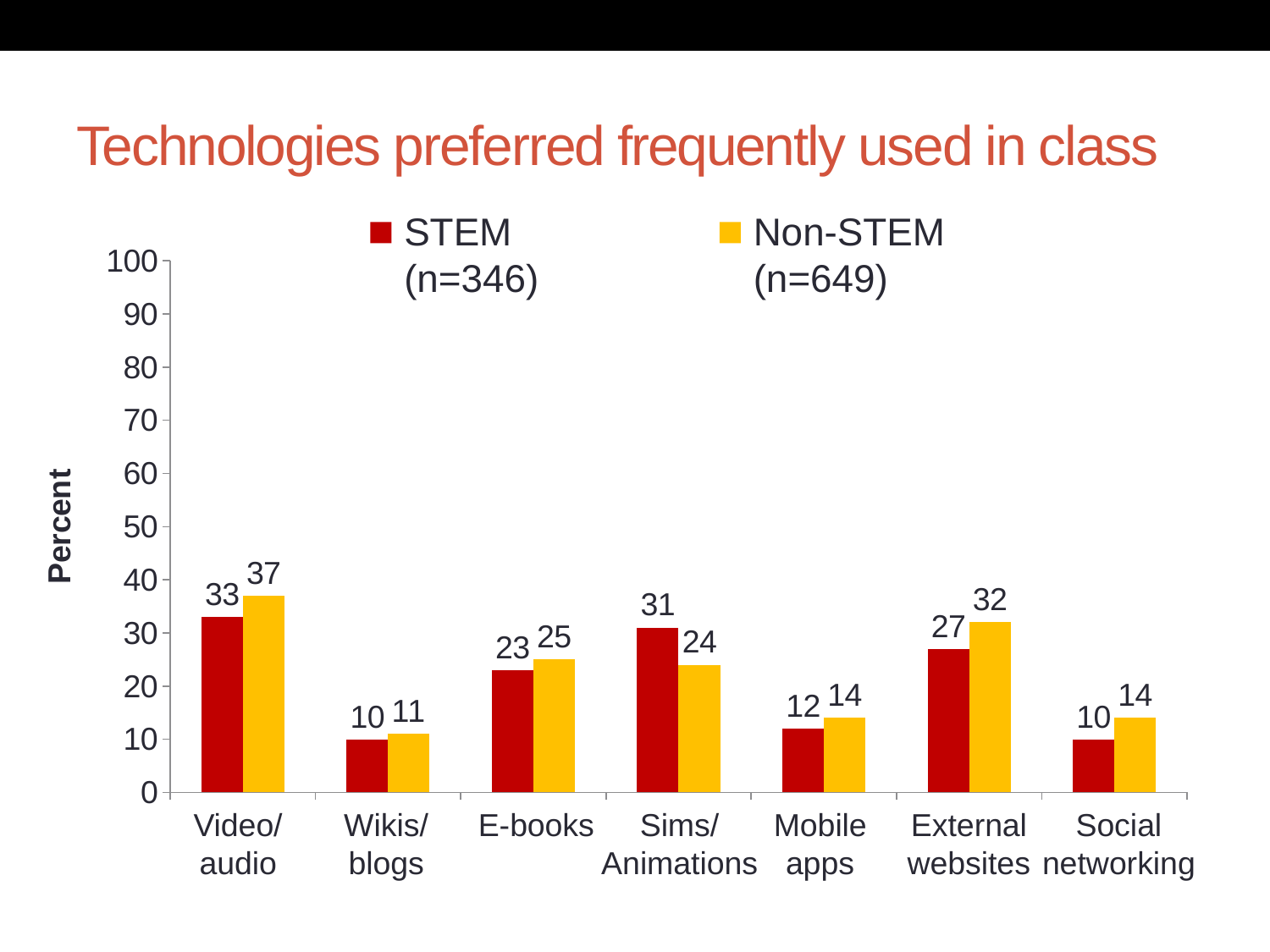
What is the title of the chart? Technologies preferred frequently used in class How many series does the legend list? 2 For Sims/Animations, which is larger, the STEM value or the Non-STEM value? STEM Which category has the highest Non-STEM value? Video/audio What is the STEM value for Video/audio? 33 Which category has the lowest Non-STEM value? Wikis/blogs What is the STEM value for Sims/Animations? 31 Is the STEM value for External websites greater or less than 20? greater How many categories are shown on the x axis? 7 What is the Non-STEM value for External websites? 32 What kind of chart is shown on the slide? bar chart What is the difference between the Non-STEM and STEM values for Video/audio? 4